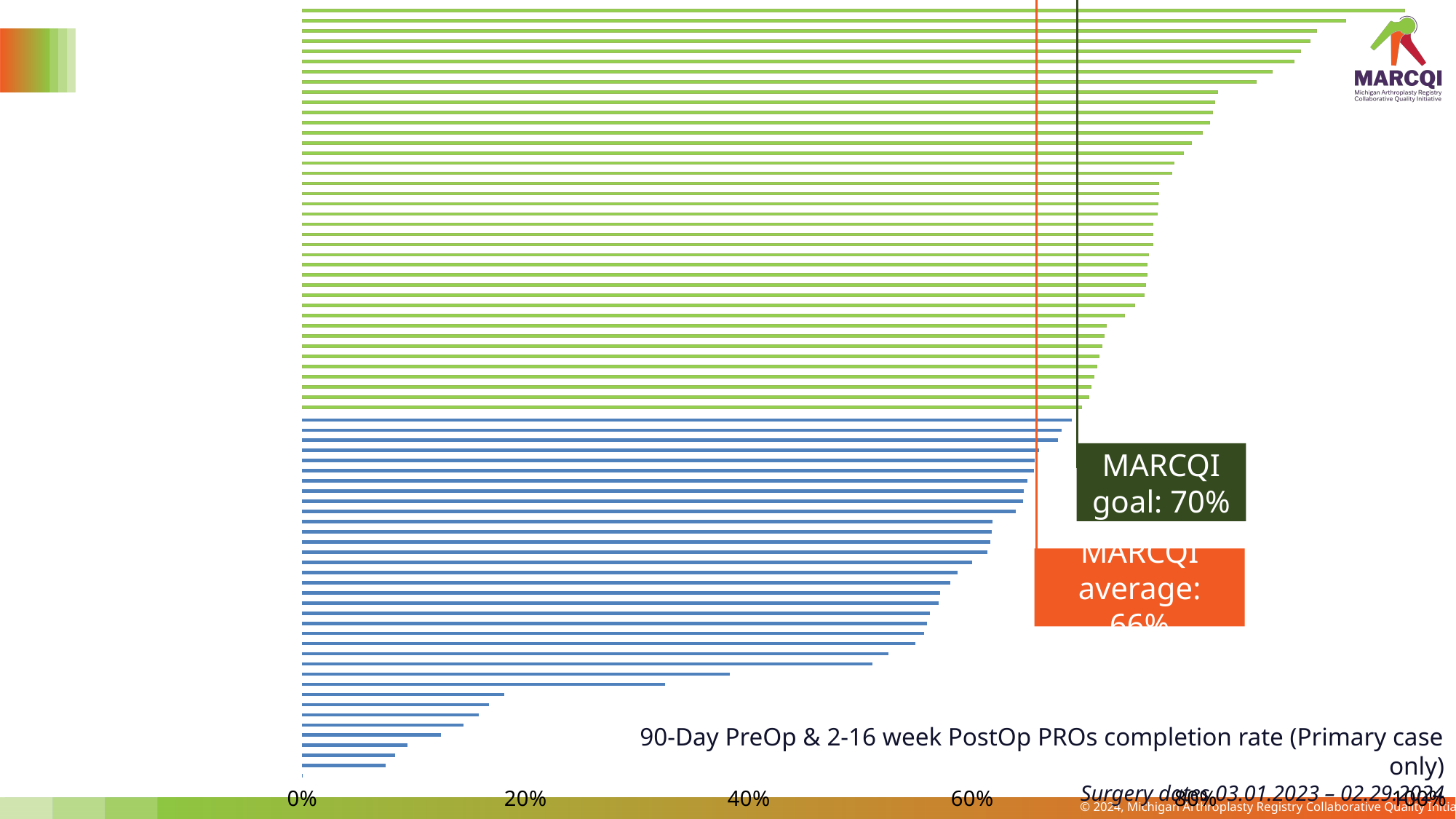
What is the difference between the MARCQI goal and the MARCQI average? 4% What colour are the bars that exceed the MARCQI goal line? Green What is the MARCQI average value shown on the chart? 66% What is the MARCQI goal value shown on the chart? 70% Is the value of the longest bar greater or less than 80%? greater What is the highest value labelled on the x axis? 100% Is the MARCQI average greater or less than 60%? greater Which is larger, the MARCQI goal or the MARCQI average? MARCQI goal What kind of chart is shown on the slide? Bar chart Do the bar values rise or fall going from the top of the chart to the bottom? Fall Is the value of the shortest bar greater or less than 20%? less